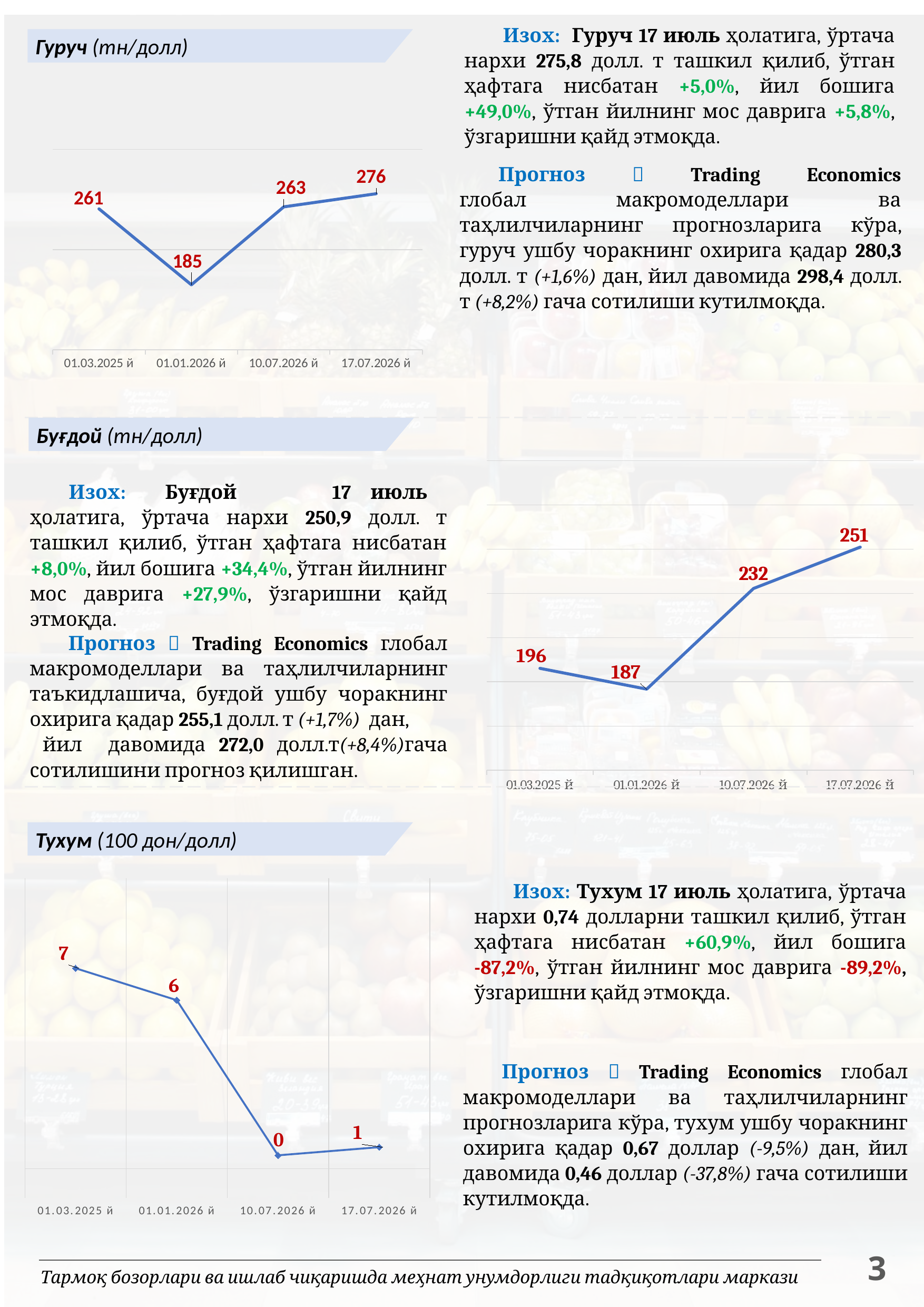
On the Тухум (100 дон/долл) chart, do the values generally rise or fall from 01.03.2025 й to 17.07.2026 й? fall On the Буғдой (тн/долл) chart, is the value for 01.03.2025 й larger or smaller than the value for 01.01.2026 й? larger On the Буғдой (тн/долл) chart, what is the value for 10.07.2026 й? 232 On the Гуруч (тн/долл) chart, which date has the highest value? 17.07.2026 й On the Гуруч (тн/долл) chart, what is the difference between the values for 17.07.2026 й and 10.07.2026 й? 13 On the Тухум (100 дон/долл) chart, what is the value for 01.03.2025 й? 7 On the Тухум (100 дон/долл) chart, which date has the lowest value? 10.07.2026 й On the Буғдой (тн/долл) chart, what is the difference between the values for 17.07.2026 й and 01.03.2025 й? 55 On the Гуруч (тн/долл) chart, what is the value for 01.01.2026 й? 185 On the Буғдой (тн/долл) chart, which date has the lowest value? 01.01.2026 й On the Гуруч (тн/долл) chart, how many data points are plotted? 4 What type of chart is the Буғдой (тн/долл) chart? line chart